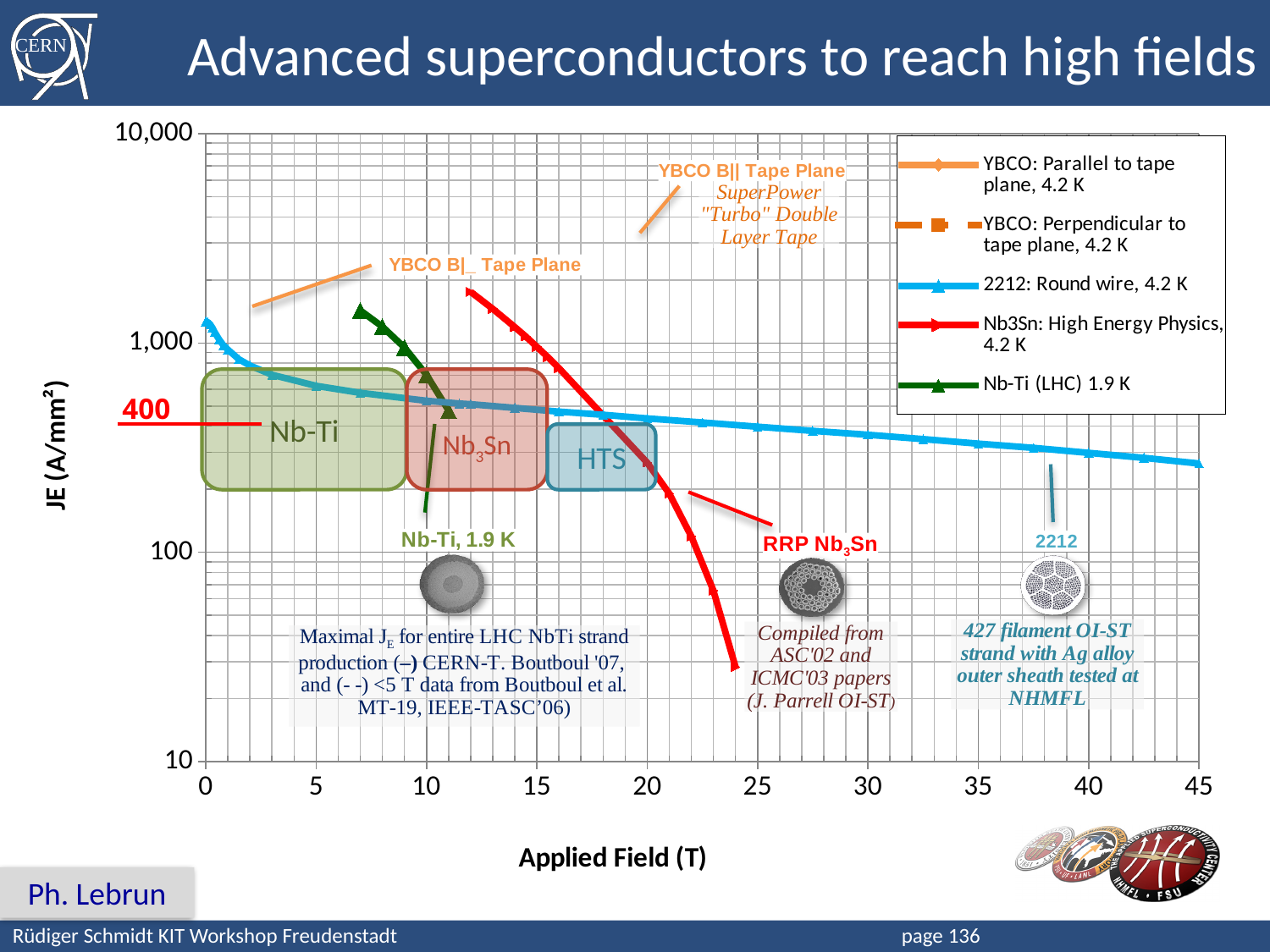
Is the JE value of the 2212 round wire series at 45 T greater or less than 400? less Is the JE value of the Nb3Sn series at 20 T greater or less than 400? less What kind of chart is shown on the slide? line chart Is the JE value of the Nb-Ti (LHC) 1.9 K series at 7 T greater or less than 1,000? greater At what temperature is the Nb-Ti (LHC) series measured according to the legend? 1.9 K Does the JE value of the 2212 round wire series rise or fall as the applied field increases? fall What is the label of the y axis of the chart? JE (A/mm²) What is the highest tick value shown on the y axis? 10,000 At 15 T, which series has the higher JE value: Nb3Sn or 2212 round wire? Nb3Sn How many series does the chart legend list? 5